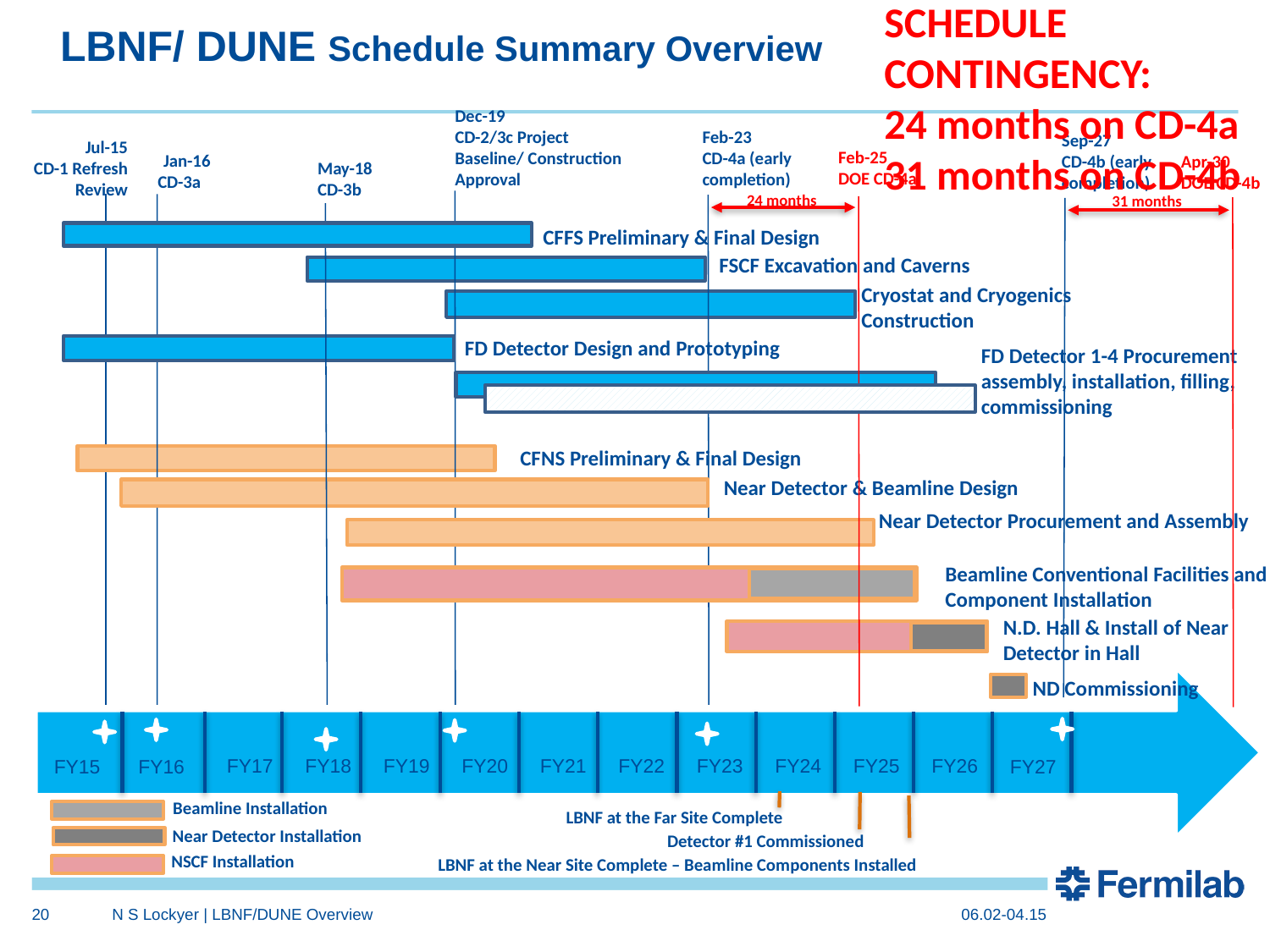
What is the date shown for the CD-3b milestone? May-18 What is the date shown for the CD-1 Refresh Review milestone? Jul-15 What is the date shown for DOE CD-4a? Feb-25 What is the date shown for CD-4a (early completion)? Feb-23 How many months of schedule contingency are shown on CD-4b? 31 months How many fiscal years are labelled along the timeline arrow at the bottom of the chart? 13 What is the difference in months between the CD-4b and CD-4a schedule contingencies? 7 months What is the date shown for the CD-3a milestone? Jan-16 Which has more schedule contingency, CD-4a or CD-4b? CD-4b What is the date shown for the CD-2/3c Project Baseline/Construction Approval milestone? Dec-19 How many entries does the legend at the bottom left of the chart list? 3 How many months of schedule contingency are shown on CD-4a? 24 months